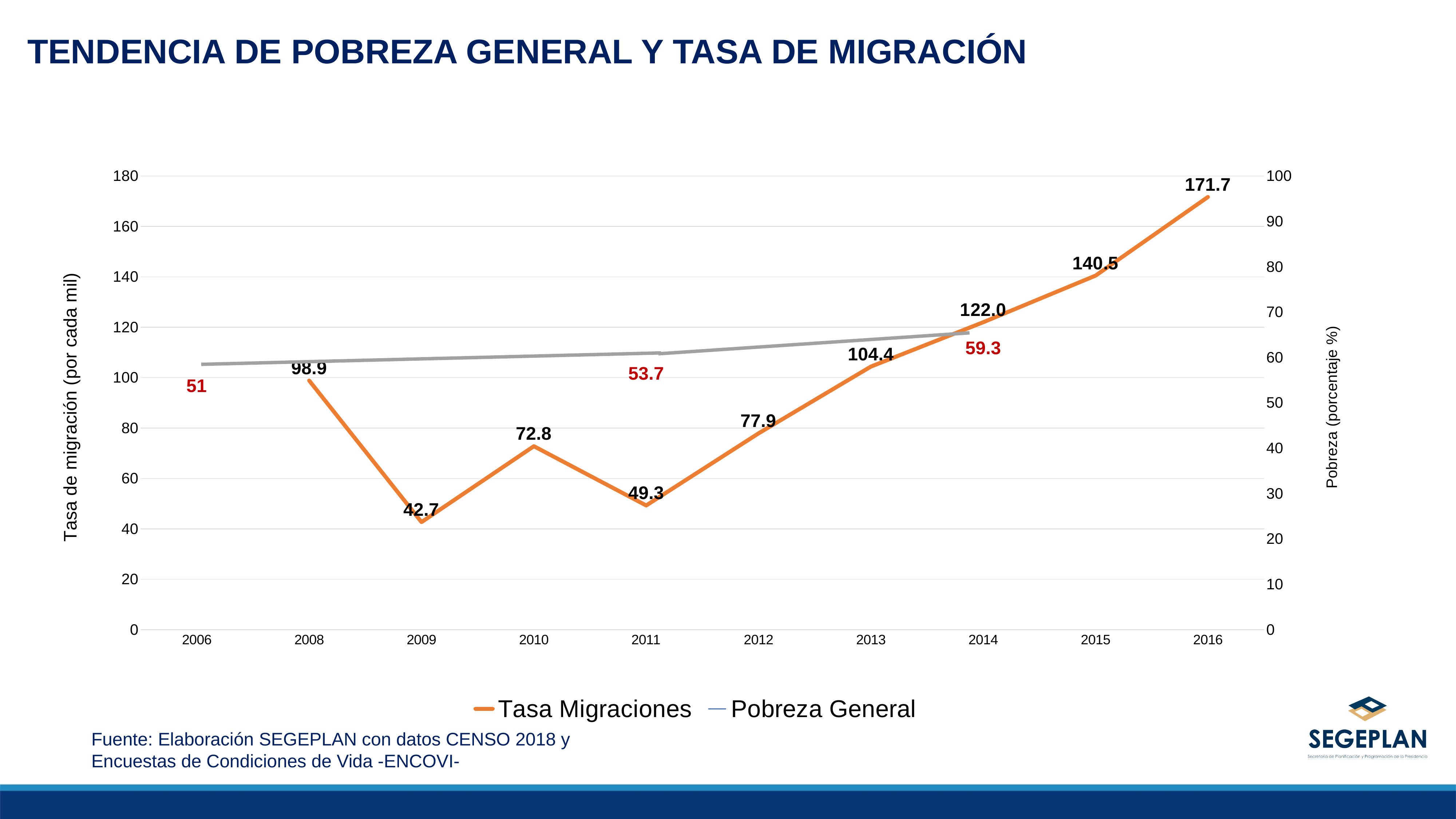
In which year is the Tasa Migraciones lowest? 2009 What is the Tasa Migraciones value for 2009? 42.7 What is the Pobreza General value for 2011? 53.7 Which is larger, the Tasa Migraciones value for 2010 or for 2011? 2010 What is the Tasa Migraciones value for 2016? 171.7 How many years are shown on the x axis? 10 How many series does the legend list? 2 What is the difference between the Tasa Migraciones values for 2016 and 2015? 31.2 Does the Tasa Migraciones rise or fall from 2011 to 2016? Rise In which year is the Tasa Migraciones highest? 2016 What kind of chart is shown on the slide? Line chart What is the Pobreza General value for 2006? 51